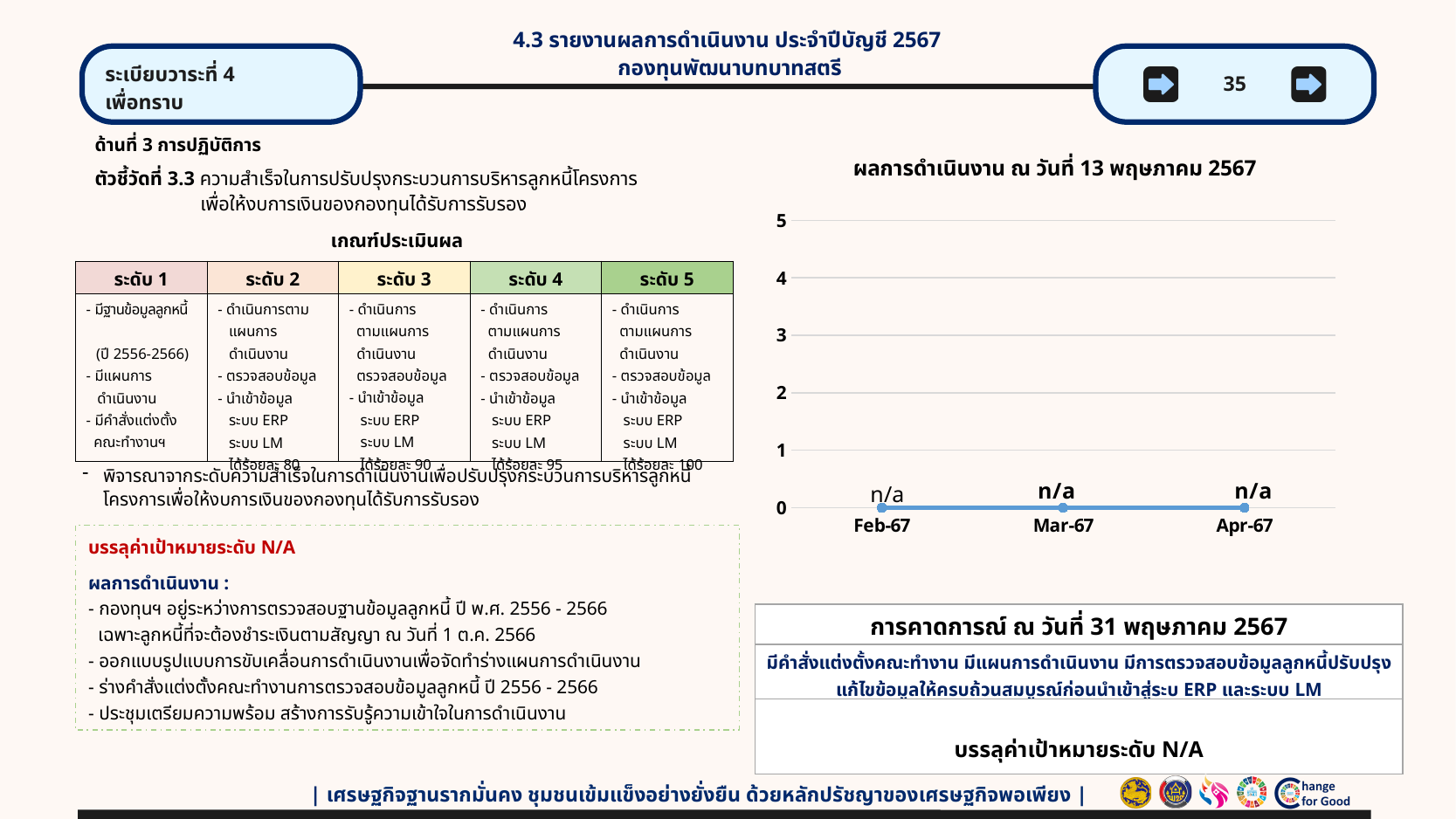
What is the data label shown for Mar-67? n/a Is the plotted value for Feb-67 greater or less than 2? less What is the highest value shown on the chart's vertical axis? 5 Do the plotted values rise, fall, or stay flat from Feb-67 to Apr-67? stay flat What kind of chart is shown on the slide? line chart Is the plotted value for Apr-67 greater or less than 1? less Which category appears first on the x axis of the chart? Feb-67 What is the data label shown for Apr-67? n/a What is the title of the chart? ผลการดำเนินงาน ณ วันที่ 13 พฤษภาคม 2567 How many data points are plotted on the chart? 3 What is the data label shown for Feb-67? n/a